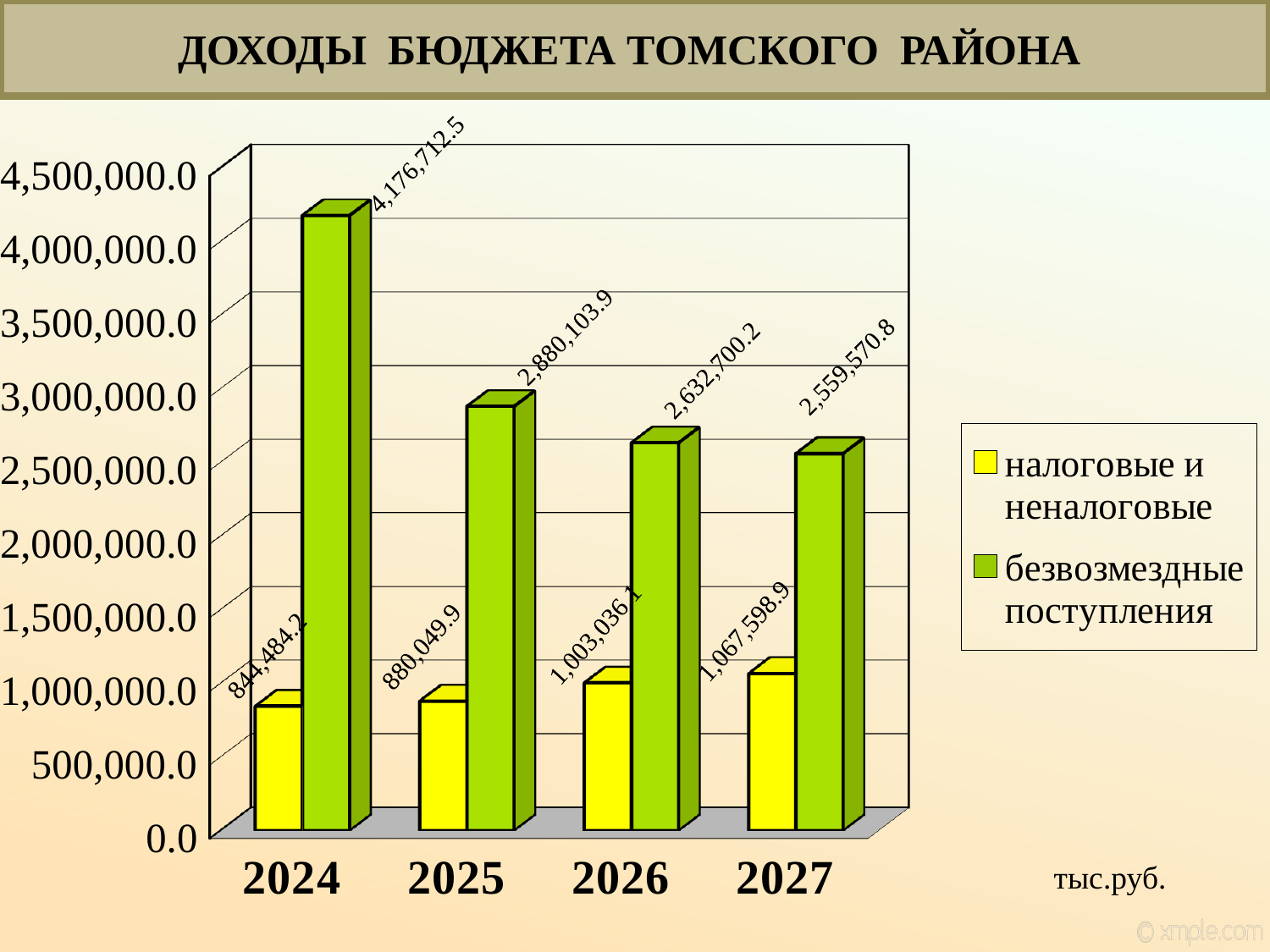
How many series does the legend list? 2 Do the values for безвозмездные поступления rise or fall from 2024 to 2027? fall What is the value for безвозмездные поступления in 2026? 2,632,700.2 What is the value for налоговые и неналоговые in 2027? 1,067,598.9 What is the difference between безвозмездные поступления and налоговые и неналоговые in 2024? 3,332,228.3 What kind of chart is shown on the slide? bar chart In which year is the value for налоговые и неналоговые lowest? 2024 How many years are shown on the x axis? 4 Is the value for налоговые и неналоговые in 2026 greater or less than 1,000,000.0? greater Which is larger in 2025: налоговые и неналоговые or безвозмездные поступления? безвозмездные поступления What is the value for безвозмездные поступления in 2024? 4,176,712.5 In which year is the value for безвозмездные поступления highest? 2024